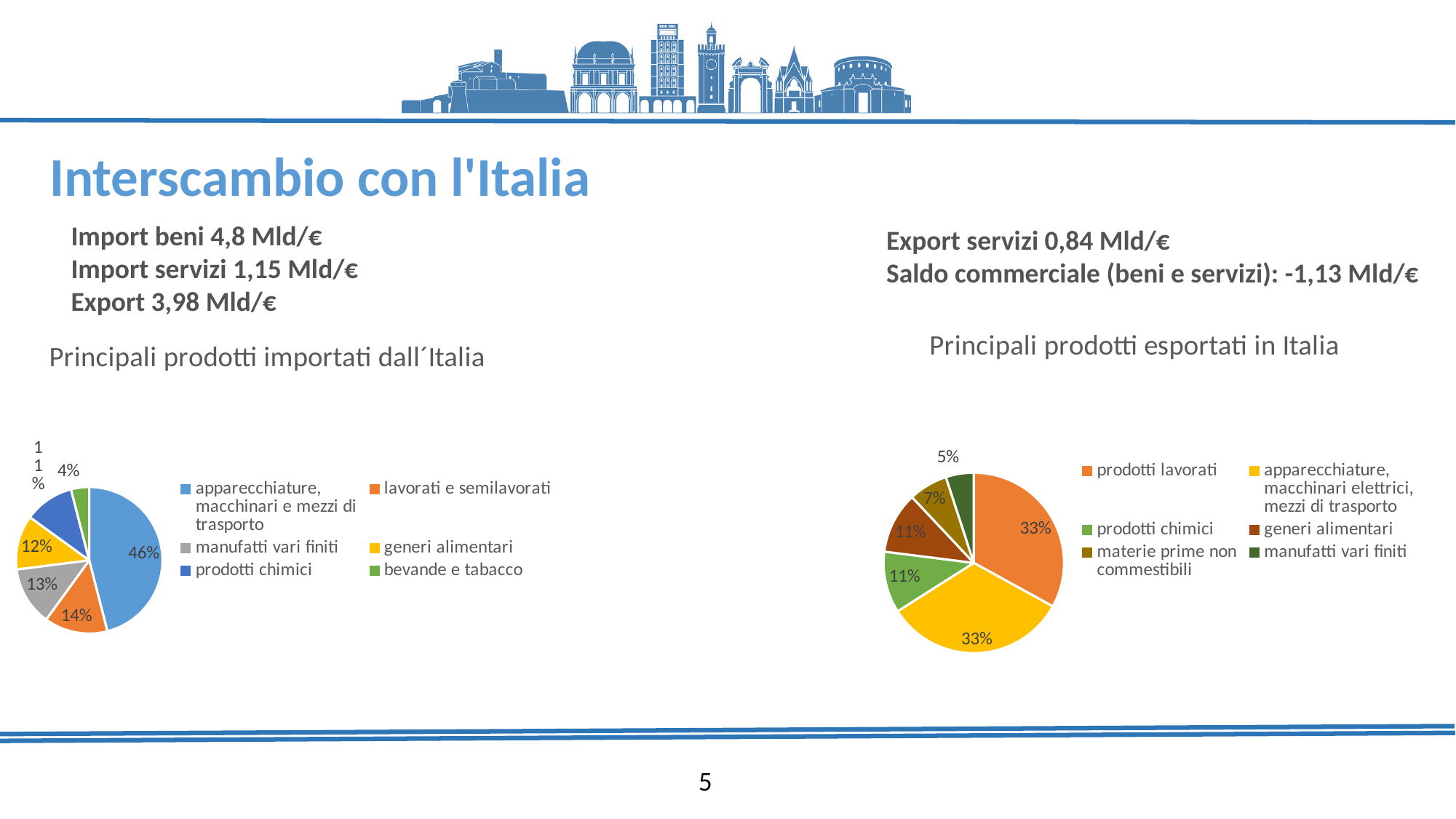
In the chart 'Principali prodotti esportati in Italia', which is larger: the share of generi alimentari or the share of manufatti vari finiti? generi alimentari In the chart 'Principali prodotti importati dall'Italia', what is the difference between the shares of lavorati e semilavorati and generi alimentari? 2% In the chart 'Principali prodotti importati dall'Italia', what share do bevande e tabacco have? 4% In the chart 'Principali prodotti esportati in Italia', which category has the smallest slice? manufatti vari finiti In the chart 'Principali prodotti importati dall'Italia', which category has the largest slice? apparecchiature, macchinari e mezzi di trasporto In the chart 'Principali prodotti esportati in Italia', what share do materie prime non commestibili have? 7% In the chart 'Principali prodotti importati dall'Italia', which category has the smallest slice? bevande e tabacco In the chart 'Principali prodotti esportati in Italia', what colour is the slice for prodotti lavorati? orange In the chart 'Principali prodotti esportati in Italia', what share do prodotti chimici have? 11% What type of chart is 'Principali prodotti esportati in Italia'? pie chart In the chart 'Principali prodotti importati dall'Italia', what share do apparecchiature, macchinari e mezzi di trasporto have? 46% How many categories does the chart 'Principali prodotti importati dall'Italia' show? 6